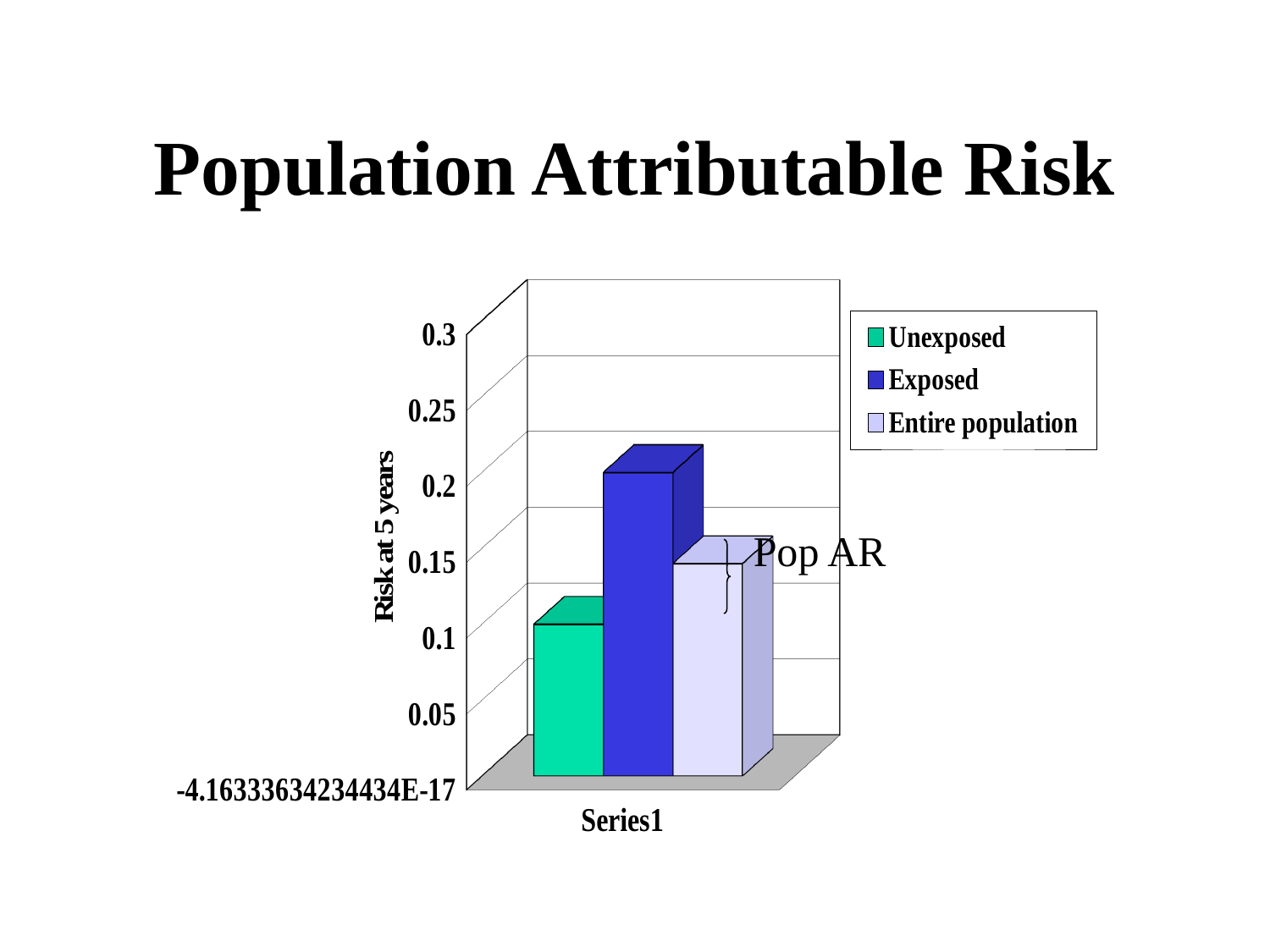
Is the value for Exposed greater or less than 0.15? greater Is the value for Exposed greater or less than 0.25? less Which is larger, the bar for Exposed or the bar for Entire population? Exposed Is the value for Unexposed greater or less than 0.15? less What label appears on the horizontal axis beneath the bars? Series1 Which series has the lowest bar? Unexposed How many series does the legend list? 3 What is the title of the vertical axis? Risk at 5 years What kind of chart is shown on the slide? bar chart Which is larger, the bar for Unexposed or the bar for Entire population? Entire population Which series has the highest bar? Exposed